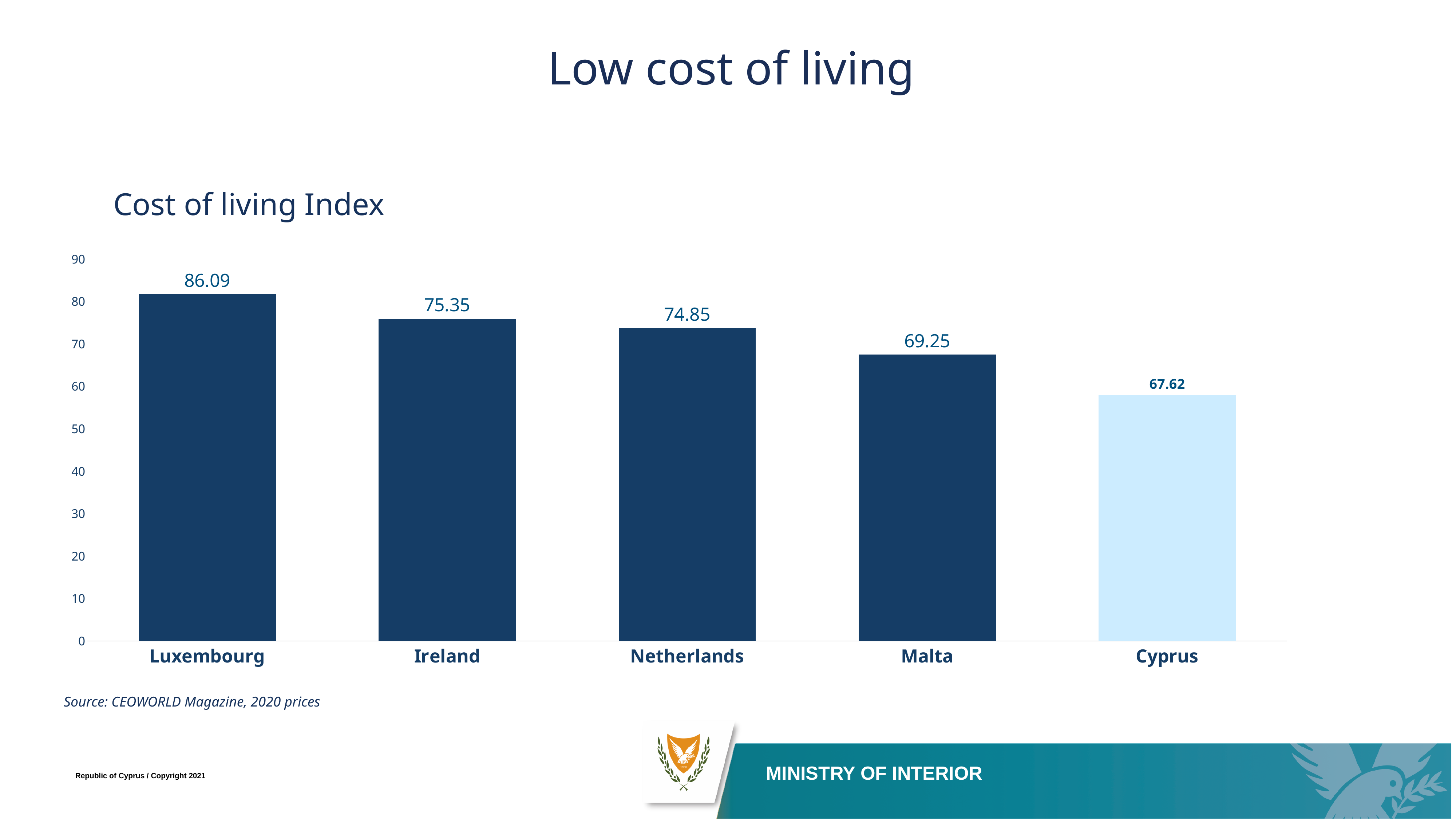
How many countries are shown in the chart? 5 Which country has the highest Cost of living Index? Luxembourg Which has a higher Cost of living Index, Ireland or Malta? Ireland What is the Cost of living Index value for Luxembourg? 86.09 What kind of chart is shown on the slide? bar chart What is the Cost of living Index value for Cyprus? 67.62 What is the difference between the Cost of living Index of Luxembourg and Cyprus? 18.47 Which country has the lowest Cost of living Index? Cyprus What is the difference between the Cost of living Index of Ireland and Malta? 6.10 Is the value for Malta greater or less than 60? greater Which country's bar is shown in a lighter colour than the others? Cyprus What is the Cost of living Index value for Netherlands? 74.85